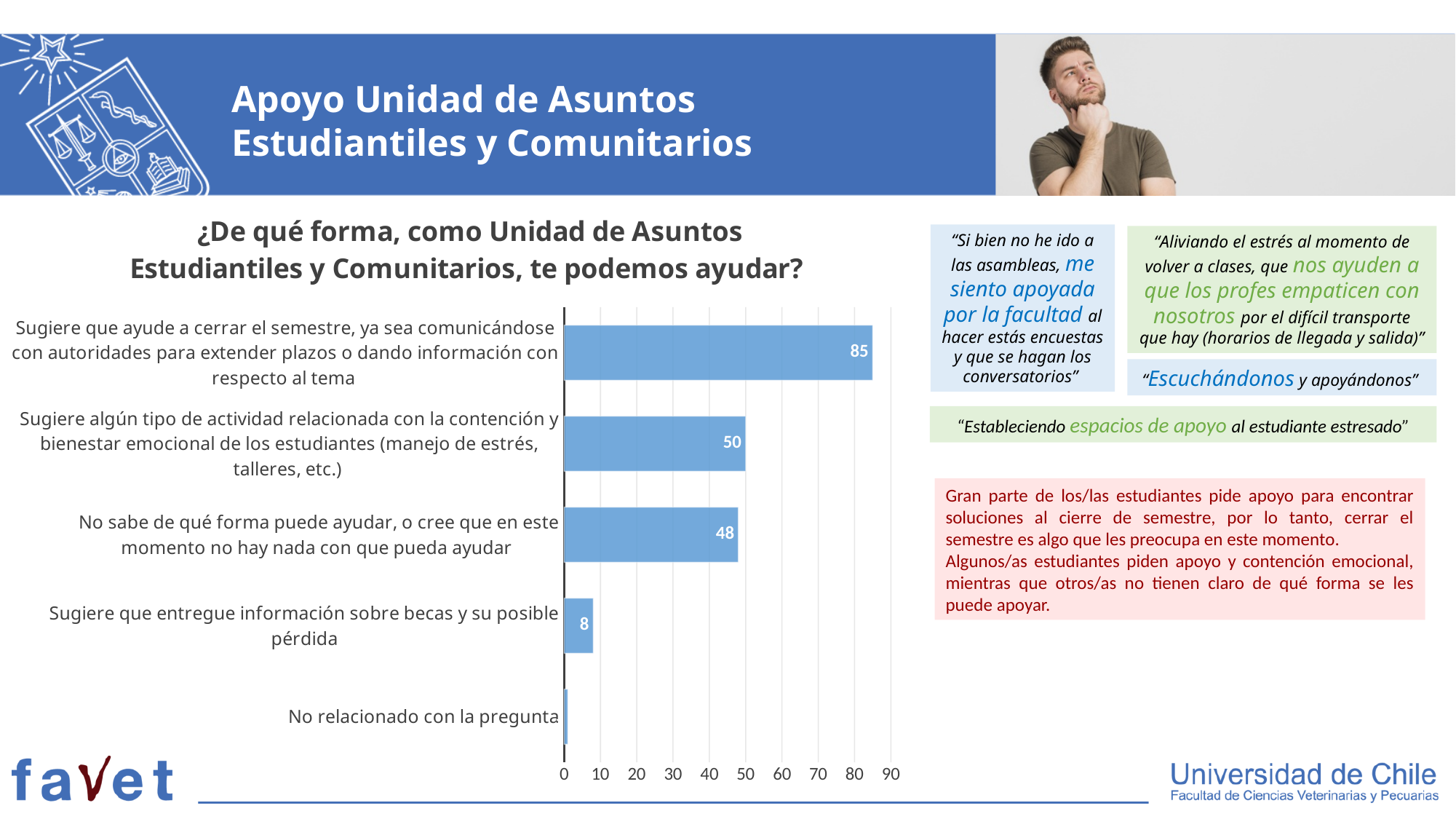
What value is shown for "Sugiere algún tipo de actividad relacionada con la contención y bienestar emocional de los estudiantes (manejo de estrés, talleres, etc.)"? 50 What is the difference between the value for "Sugiere que ayude a cerrar el semestre..." (85) and the value for "Sugiere algún tipo de actividad relacionada con la contención y bienestar emocional..." (50)? 35 How many categories are shown in the chart? 5 What value is shown for "No sabe de qué forma puede ayudar, o cree que en este momento no hay nada con que pueda ayudar"? 48 Which category has the lowest value in the chart? No relacionado con la pregunta What is the difference between the value for "No sabe de qué forma puede ayudar..." and the value for "Sugiere que entregue información sobre becas y su posible pérdida"? 40 Which category has the highest value in the chart? Sugiere que ayude a cerrar el semestre, ya sea comunicándose con autoridades para extender plazos o dando información con respecto al tema Which is larger: the value for "Sugiere algún tipo de actividad relacionada con la contención y bienestar emocional..." or the value for "Sugiere que entregue información sobre becas y su posible pérdida"? Sugiere algún tipo de actividad relacionada con la contención y bienestar emocional de los estudiantes (manejo de estrés, talleres, etc.) What kind of chart is shown on the slide? Bar chart What value is shown for the category "Sugiere que ayude a cerrar el semestre, ya sea comunicándose con autoridades para extender plazos o dando información con respecto al tema"? 85 What value is shown for "Sugiere que entregue información sobre becas y su posible pérdida"? 8 Is the value for "No relacionado con la pregunta" greater or less than 10? less